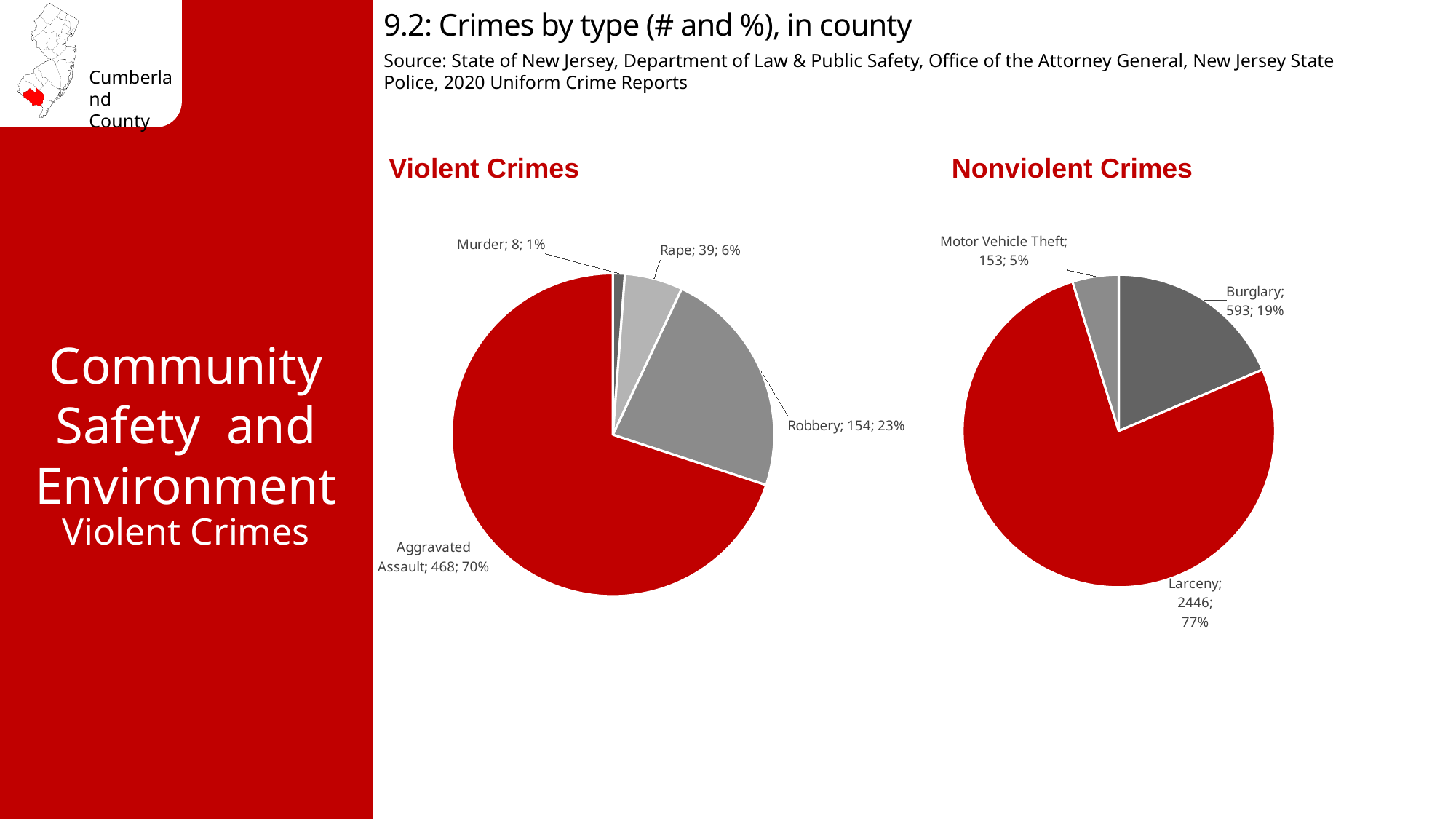
In the Nonviolent Crimes chart, how many Larceny crimes are shown? 2446 In the Violent Crimes chart, which category has the smallest slice? Murder In the Violent Crimes chart, what share of the pie is Robbery? 23% In the Nonviolent Crimes chart, which is larger, Burglary or Motor Vehicle Theft? Burglary In the Nonviolent Crimes chart, what share of the pie is Burglary? 19% In the Nonviolent Crimes chart, what is the difference between the number of Burglary and Motor Vehicle Theft crimes? 440 In the Nonviolent Crimes chart, which category has the smallest slice? Motor Vehicle Theft In the Violent Crimes chart, how many Aggravated Assault crimes are shown? 468 In the Violent Crimes chart, how many categories are shown? 4 In the Violent Crimes chart, which category has the largest slice? Aggravated Assault In the Violent Crimes chart, what is the difference between the number of Robbery and Rape crimes? 115 What type of chart is used for the Violent Crimes chart? Pie chart